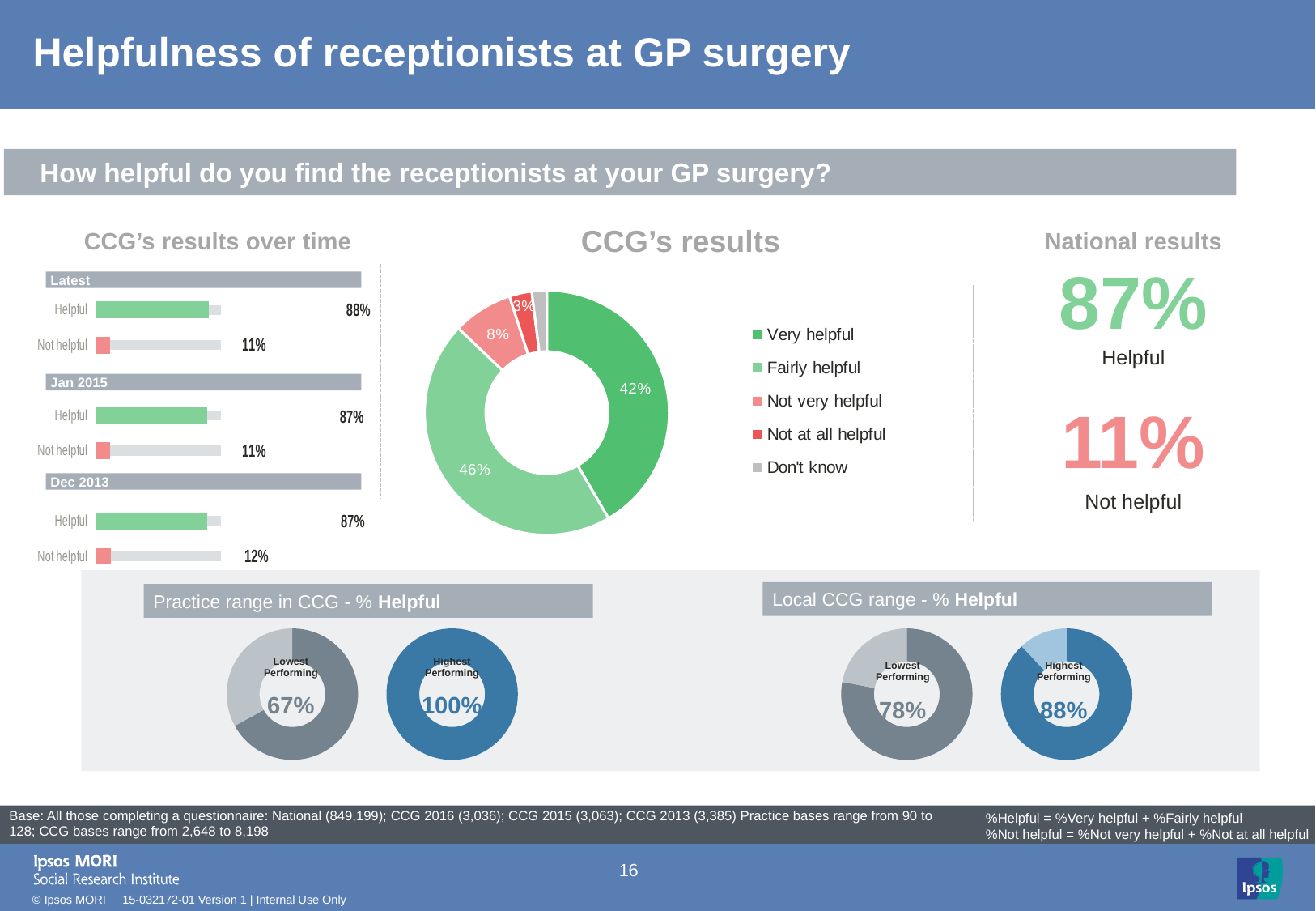
In the 'Practice range in CCG - % Helpful' chart, what is the Lowest Performing value? 67% In the 'Practice range in CCG - % Helpful' chart, what is the difference between the Highest Performing and Lowest Performing values? 33 percentage points In the 'CCG's results over time' chart, what is the Helpful value for Latest? 88% In the 'CCG's results over time' chart, how many time periods are shown? 3 In the 'CCG's results over time' chart, what is the Not helpful value for Dec 2013? 12% In the 'CCG's results' donut chart, what percentage is shown for Very helpful? 42% In the 'CCG's results' donut chart, what percentage is shown for Fairly helpful? 46% In the 'CCG's results' donut chart, which category has the largest share? Fairly helpful How many entries does the legend of the 'CCG's results' chart list? 5 In the 'CCG's results' donut chart, what percentage is shown for Not very helpful? 8% What kind of chart is the 'CCG's results' chart? Donut (pie) chart In the 'Local CCG range - % Helpful' chart, what is the Highest Performing value? 88%